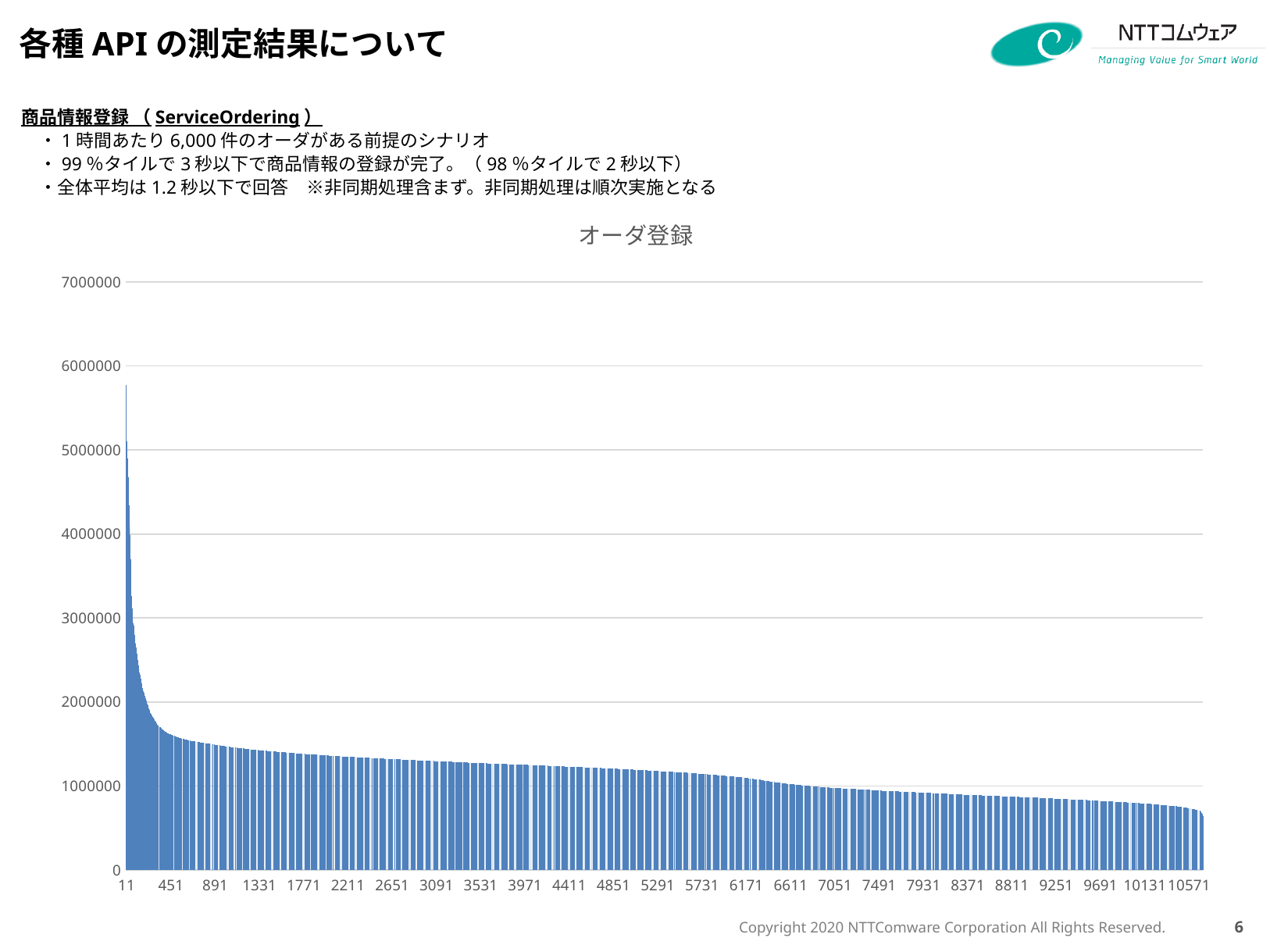
Is the value at x = 2211 greater or less than 1000000? greater What is the highest value shown on the y axis? 7000000 What kind of chart is shown on the slide? bar chart Is the value at x = 10571 greater or less than 1000000? less Do the values rise or fall moving from left to right along the x axis? fall Which is larger, the value at x = 451 or the value at x = 10571? 451 What is the title of the chart? オーダ登録 Is the value at x = 451 greater or less than 2000000? less Which is larger, the value at x = 3091 or the value at x = 9251? 3091